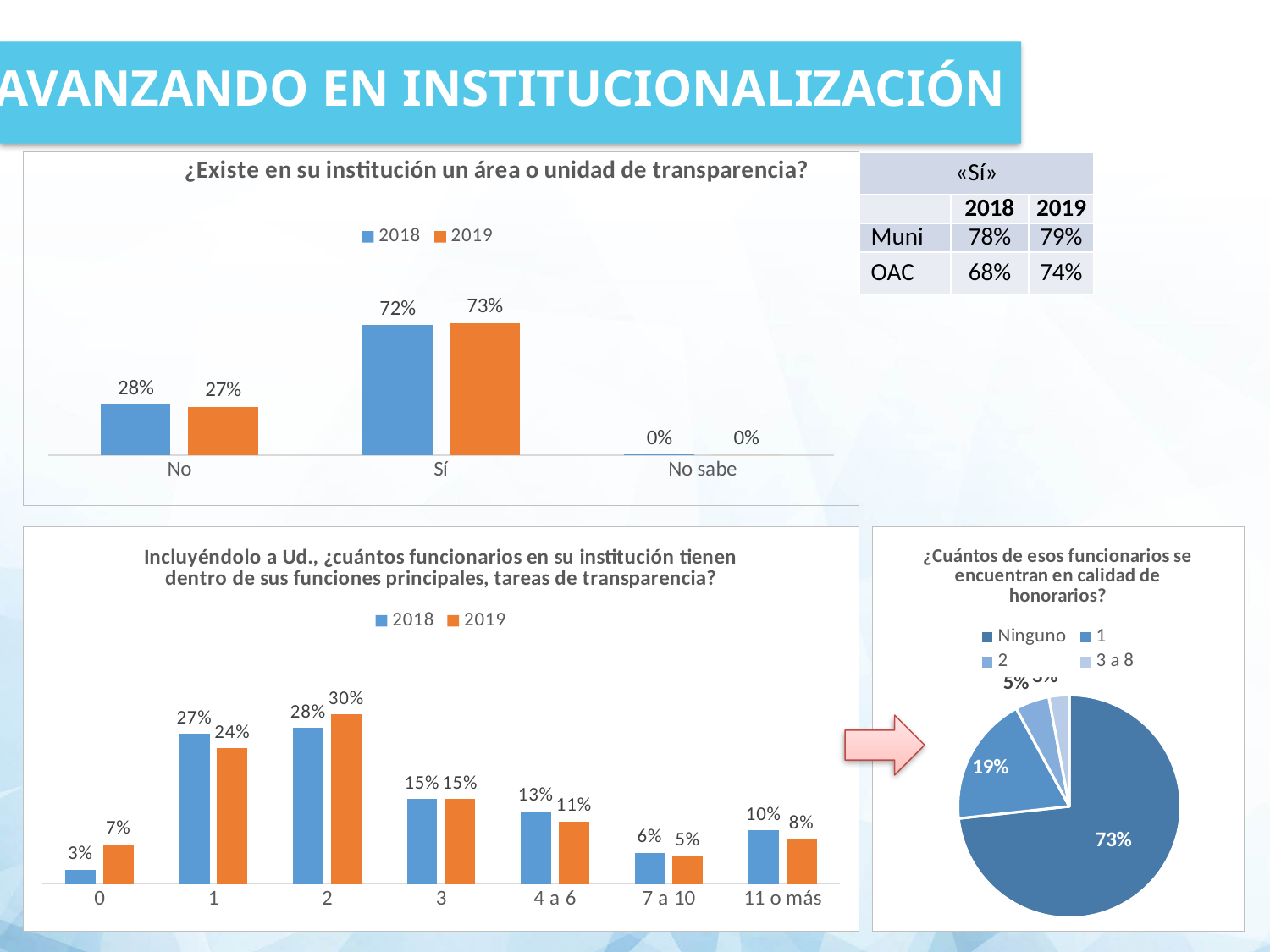
In the bottom-left chart about how many funcionarios have transparency tasks, what is the 2018 value for category '0'? 3% In the top chart '¿Existe en su institución un área o unidad de transparencia?', what is the difference between the 2019 and 2018 values for 'Sí'? 1% In the bottom-left chart about how many funcionarios have transparency tasks, what is the 2019 value for category '2'? 30% How many series does the legend of the top chart '¿Existe en su institución un área o unidad de transparencia?' list? 2 In the top chart '¿Existe en su institución un área o unidad de transparencia?', which category has the lowest values? No sabe How many categories are shown on the x axis of the bottom-left chart about how many funcionarios have transparency tasks? 7 What kind of chart is the bottom-right chart '¿Cuántos de esos funcionarios se encuentran en calidad de honorarios?'? Pie chart In the pie chart '¿Cuántos de esos funcionarios se encuentran en calidad de honorarios?', what share does 'Ninguno' have? 73% In the bottom-left chart about how many funcionarios have transparency tasks, is the 2018 value for '1' larger or the 2019 value for '1'? 2018 In the top chart '¿Existe en su institución un área o unidad de transparencia?', what is the 2019 value for 'No'? 27% In the top chart '¿Existe en su institución un área o unidad de transparencia?', what is the 2018 value for 'Sí'? 72% In the bottom-left chart about how many funcionarios have transparency tasks, which category has the highest 2019 value? 2